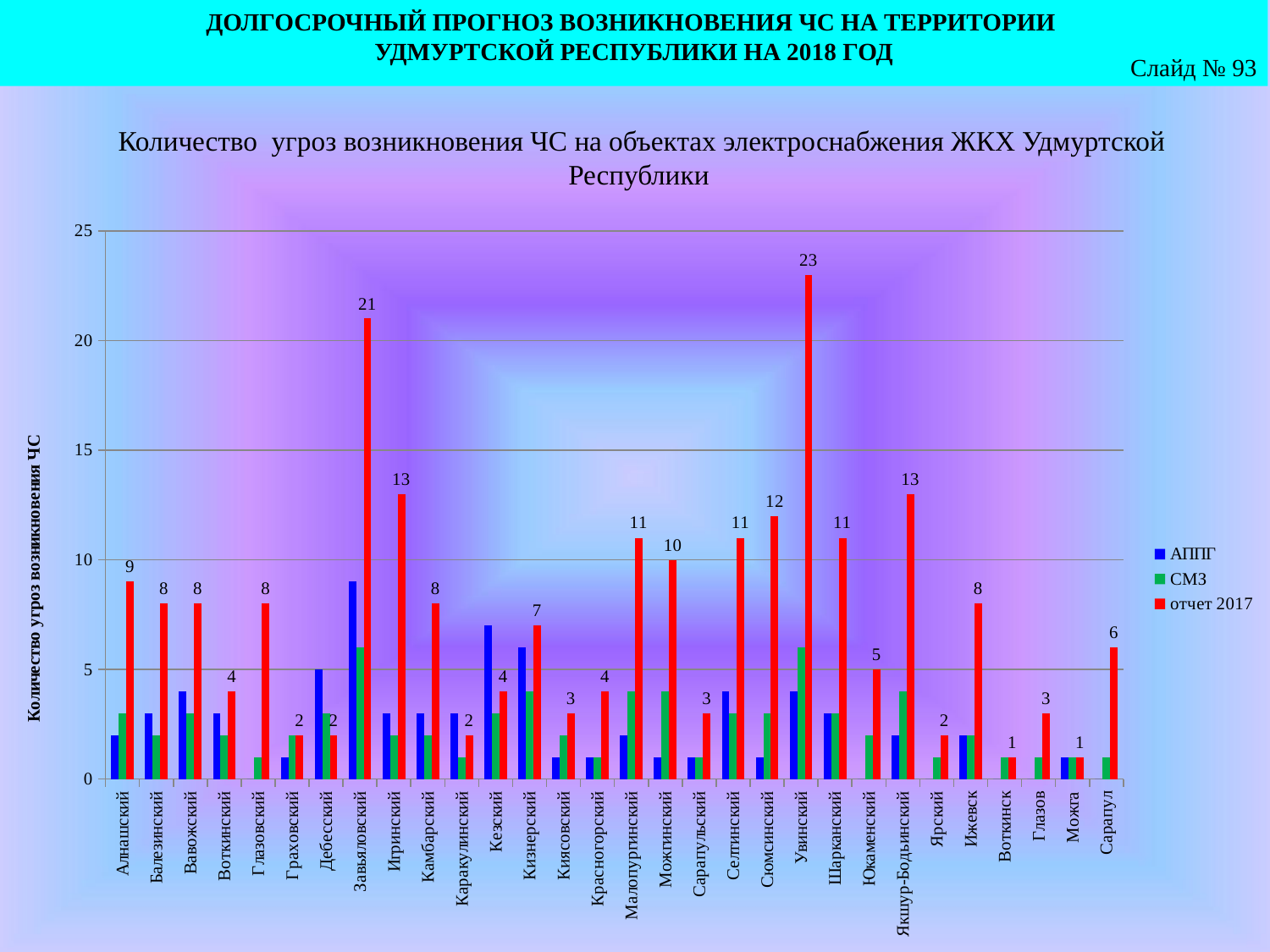
Which is larger in the 'отчет 2017' series: Сюмсинский or Можгинский? Сюмсинский What is the value of the 'отчет 2017' series for Сарапул? 6 What is the label of the y axis? Количество угроз возникновения ЧС What is the difference between the 'отчет 2017' values for Увинский and Завьяловский? 2 How many series does the legend list? 3 What is the value of the 'отчет 2017' series for Завьяловский? 21 What is the value of the 'отчет 2017' series for Увинский? 23 Which category has the highest value in the 'отчет 2017' series? Увинский What kind of chart is shown on the slide? bar chart How many categories are shown on the x axis? 30 Is the 'АППГ' value for Завьяловский greater or less than 5? greater What is the value of the 'отчет 2017' series for Игринский? 13